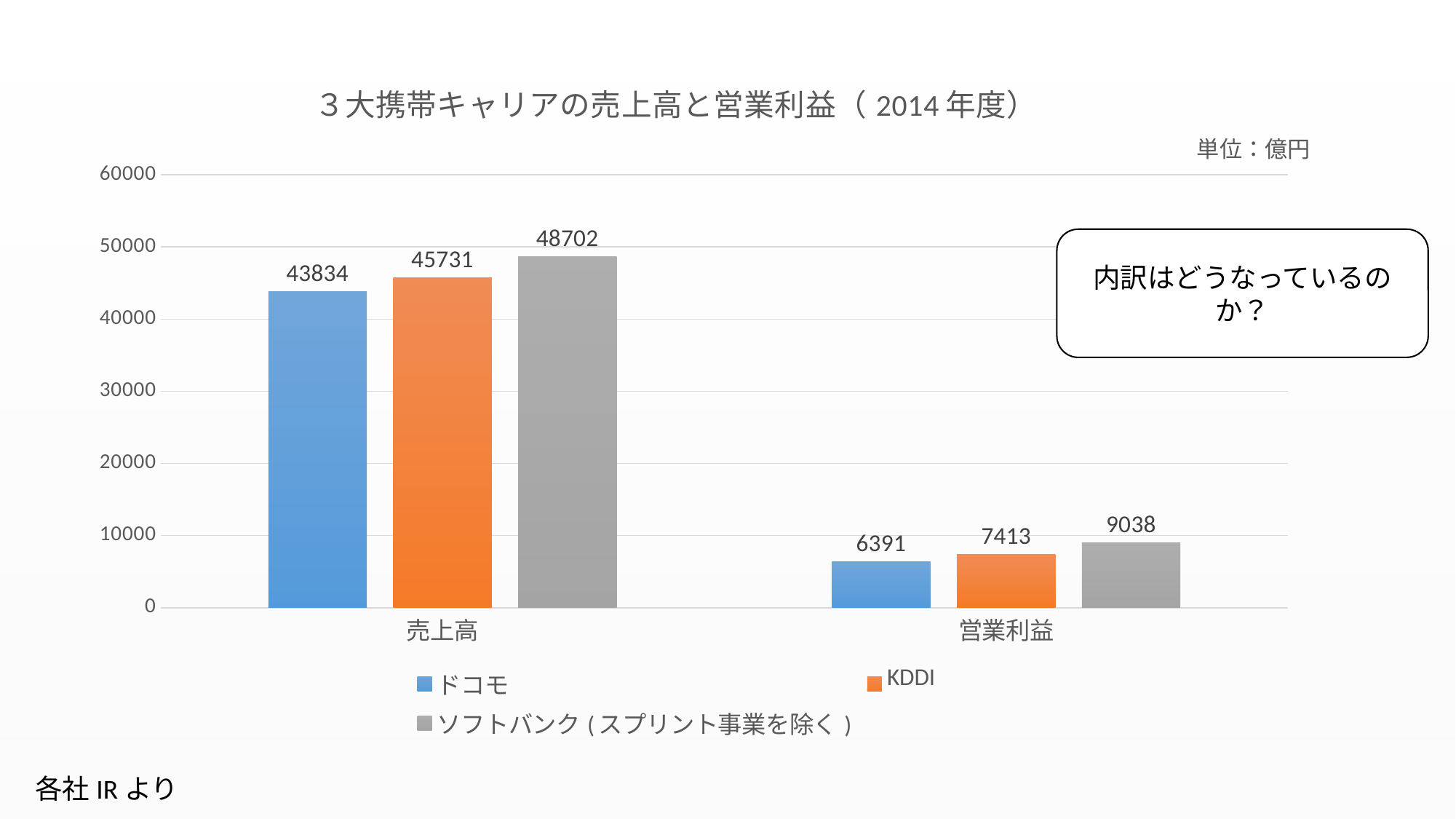
What kind of chart is shown on the slide? bar chart What unit is stated for the values in the chart? 億円 Which is larger, the 営業利益 of KDDI or of ドコモ? KDDI What is the difference between the 営業利益 of ソフトバンク (スプリント事業を除く) and ドコモ? 2647 What is the 売上高 value for ドコモ? 43834 Which company has the highest 売上高? ソフトバンク (スプリント事業を除く) What is the difference between the 売上高 of KDDI and ドコモ? 1897 Is the 営業利益 value for ソフトバンク (スプリント事業を除く) greater or less than 10000? less What is the 営業利益 value for KDDI? 7413 Which company has the lowest 営業利益? ドコモ How many series does the legend list? 3 What is the 売上高 value for ソフトバンク (スプリント事業を除く)? 48702